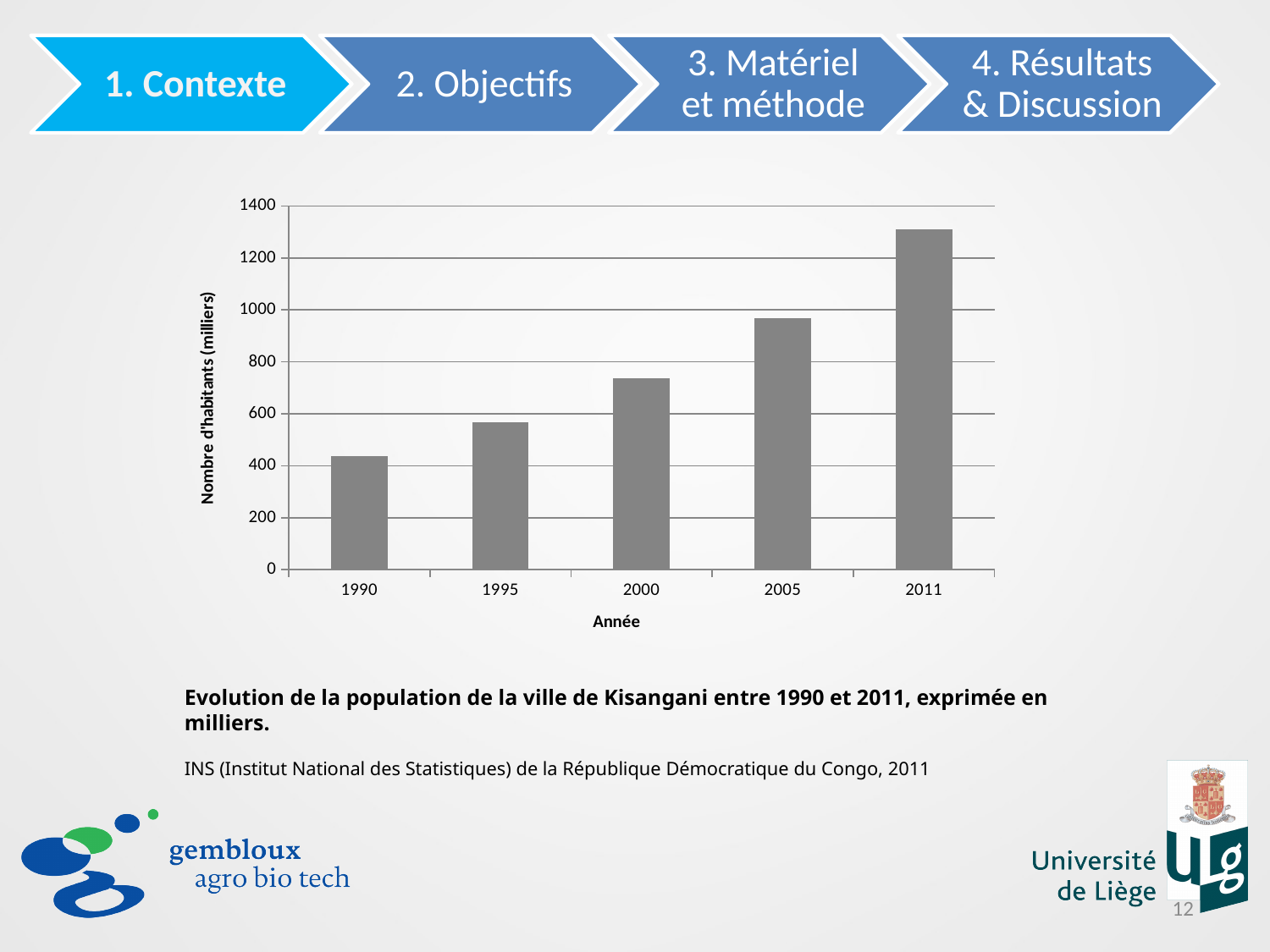
Is the value for 2011 greater or less than 1200? greater Which year has the highest population in the chart? 2011 Which year has the lowest population in the chart? 1990 Do the values rise or fall from 1990 to 2011 along the x axis? rise Which is larger, the value for 2005 or the value for 2000? 2005 Is the value for 2005 greater or less than 800? greater What kind of chart is shown on the slide? bar chart Is the value for 1995 greater or less than 400? greater What is the title of the y axis of the chart? Nombre d'habitants (milliers) How many years are shown on the x axis of the chart? 5